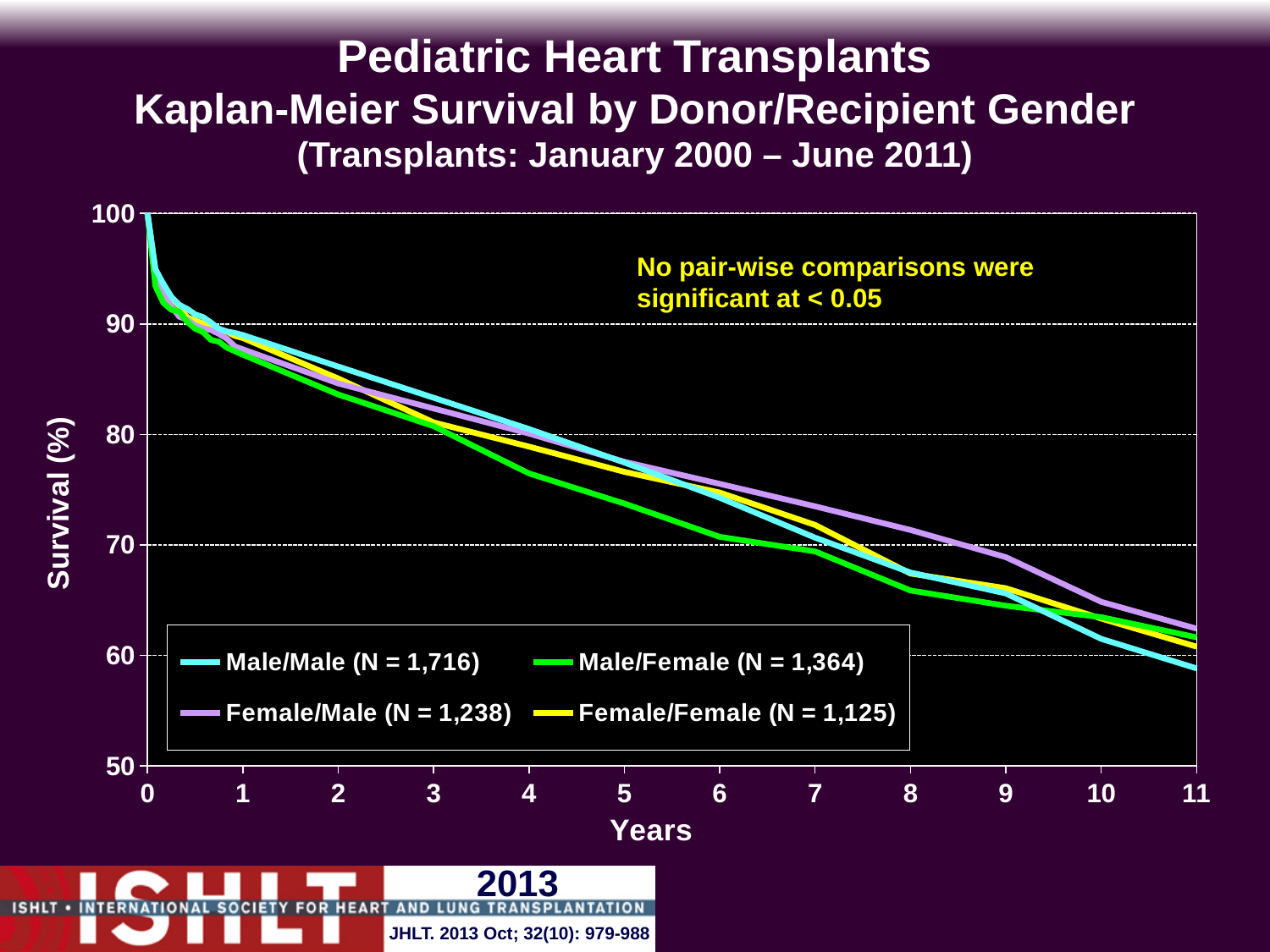
What kind of chart is shown on the slide? line chart Is the survival value for Male/Male at year 11 greater or less than 60? less At year 4, which series has higher survival, Male/Male or Male/Female? Male/Male What is the N shown in the legend for the Male/Male series? 1,716 What is the label of the y axis? Survival (%) Do the survival curves rise or fall as the years increase? fall Is the survival value for Female/Male at year 8 greater or less than 70? greater At year 8, which series has higher survival, Female/Male or Male/Female? Female/Male Is the survival value for Female/Female at year 6 greater or less than 70? greater Which series has the lowest survival at year 11? Male/Male How many series does the legend list? 4